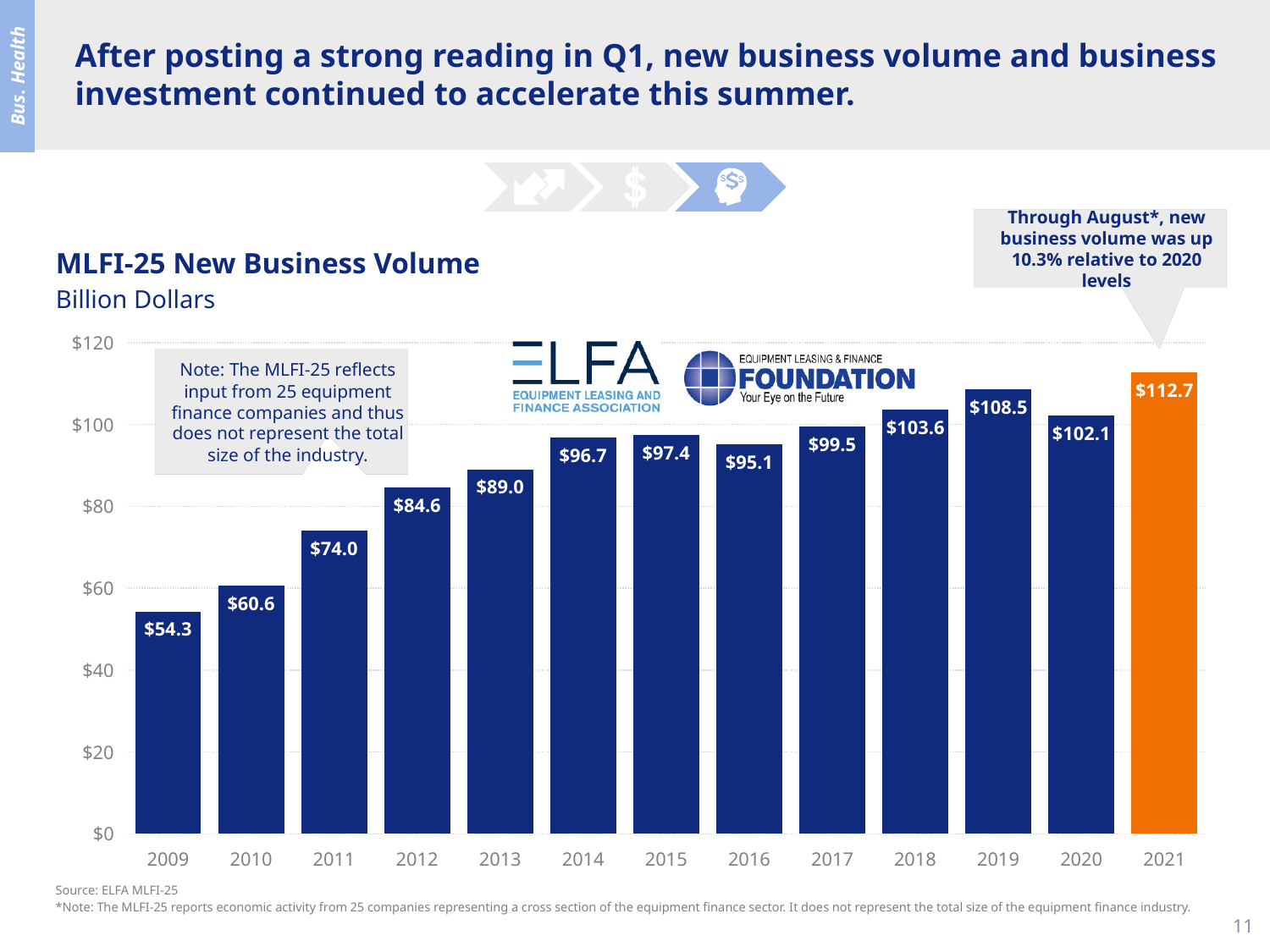
What is the MLFI-25 new business volume for 2020? $102.1 What kind of chart is shown on the slide? Bar chart What is the difference between the 2021 and 2020 new business volumes? $10.6 What is the MLFI-25 new business volume for 2013? $89.0 Which year has the lowest new business volume? 2009 Do the values generally rise or fall from 2009 to 2014? Rise Which bar is coloured orange rather than dark blue? 2021 Is the value for 2012 greater or less than $80? greater How many years are shown on the x axis? 13 Which year has the highest new business volume? 2021 Which year has a larger new business volume, 2015 or 2016? 2015 What is the difference between the 2019 and 2018 new business volumes? $4.9